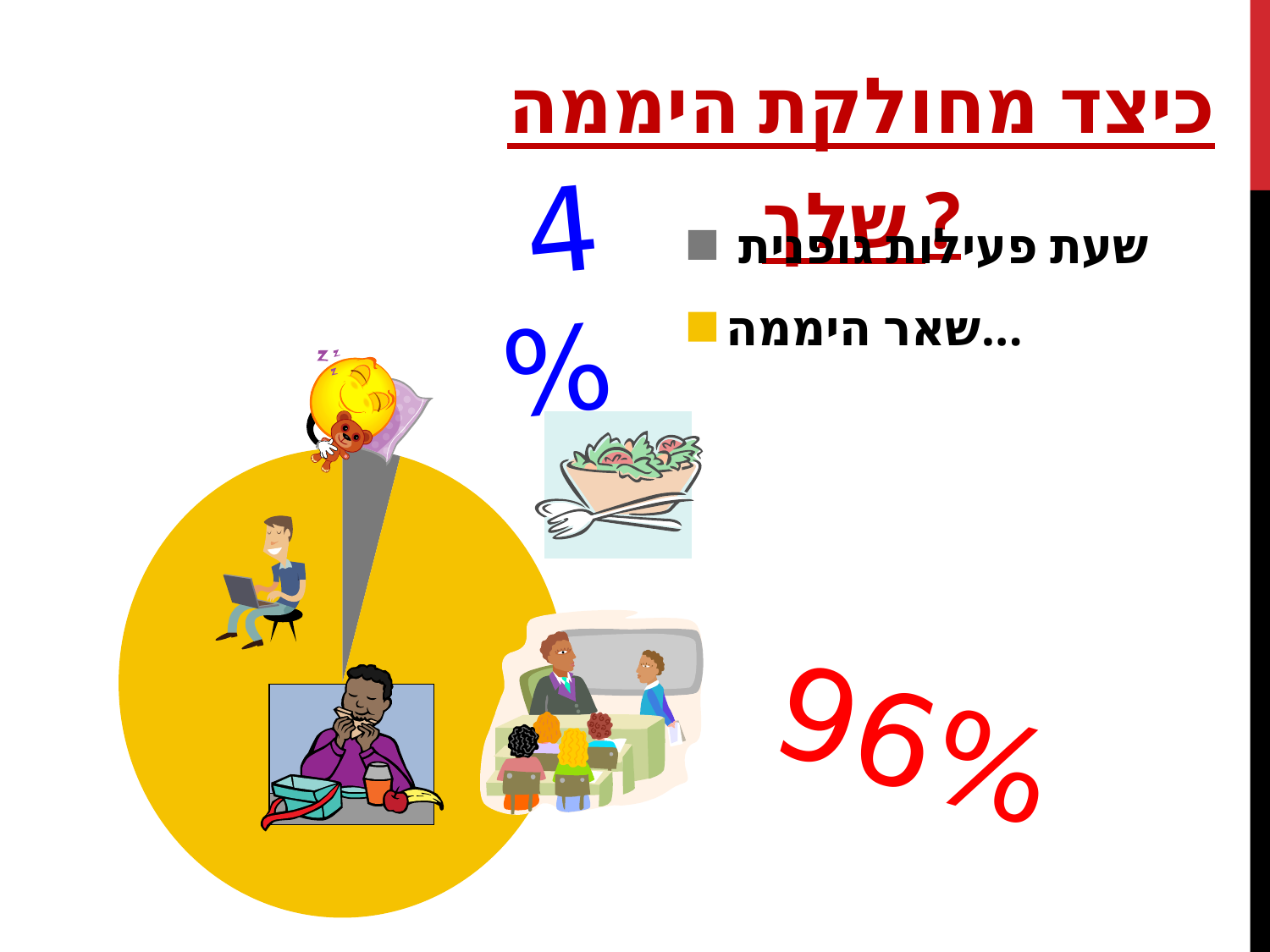
How many entries does the legend list? 2 What is the difference in percentage points between the "שאר היממה..." slice and the "שעת פעילות גופנית" slice? 92 Which is larger: the "שעת פעילות גופנית" slice or the "שאר היממה..." slice? שאר היממה... How many slices does the pie chart have? 2 Which slice of the pie chart is the largest? שאר היממה... What percentage of the day does the slice labelled "שאר היממה..." represent? 96% What colour is the "שעת פעילות גופנית" slice in the pie chart? gray What kind of chart is shown on the slide? pie chart What colour is the "שאר היממה..." slice in the pie chart? yellow What is the total of the two slice percentages shown on the pie chart? 100% Which slice of the pie chart is the smallest? שעת פעילות גופנית What percentage of the day does the slice labelled "שעת פעילות גופנית" represent? 4%